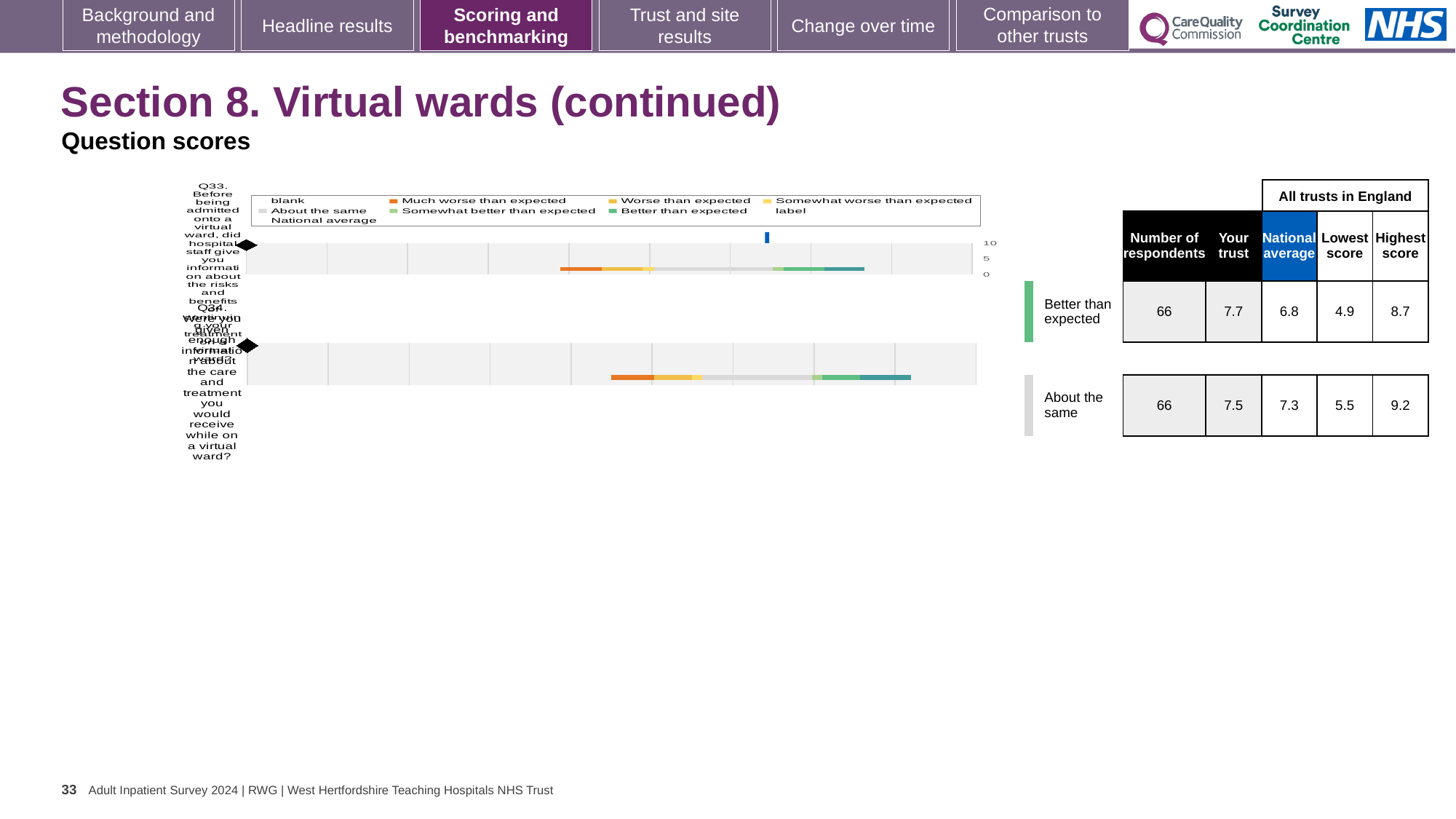
For Q33 (the top row), which is larger: the 'Your trust' score or the national average? Your trust For Q33 (the top row), what is the difference between the 'Your trust' score and the national average? 0.9 What is the lowest score among all trusts in England for Q34 (the bottom row)? 5.5 What is the national average score for Q34 (the bottom row)? 7.3 What is the national average score for Q33 (the top row)? 6.8 How many questions (rows) are plotted in the chart? 2 How many respondents answered Q33 (the top row)? 66 Which benchmark category is shown for Q33 (the top row)? Better than expected What is the highest score among all trusts in England for Q33 (the top row)? 8.7 What kind of chart is used to show the question scores on this slide? bar chart What is the 'Your trust' score for Q34 (the bottom row)? 7.5 What is the 'Your trust' score for Q33 (the top row)? 7.7